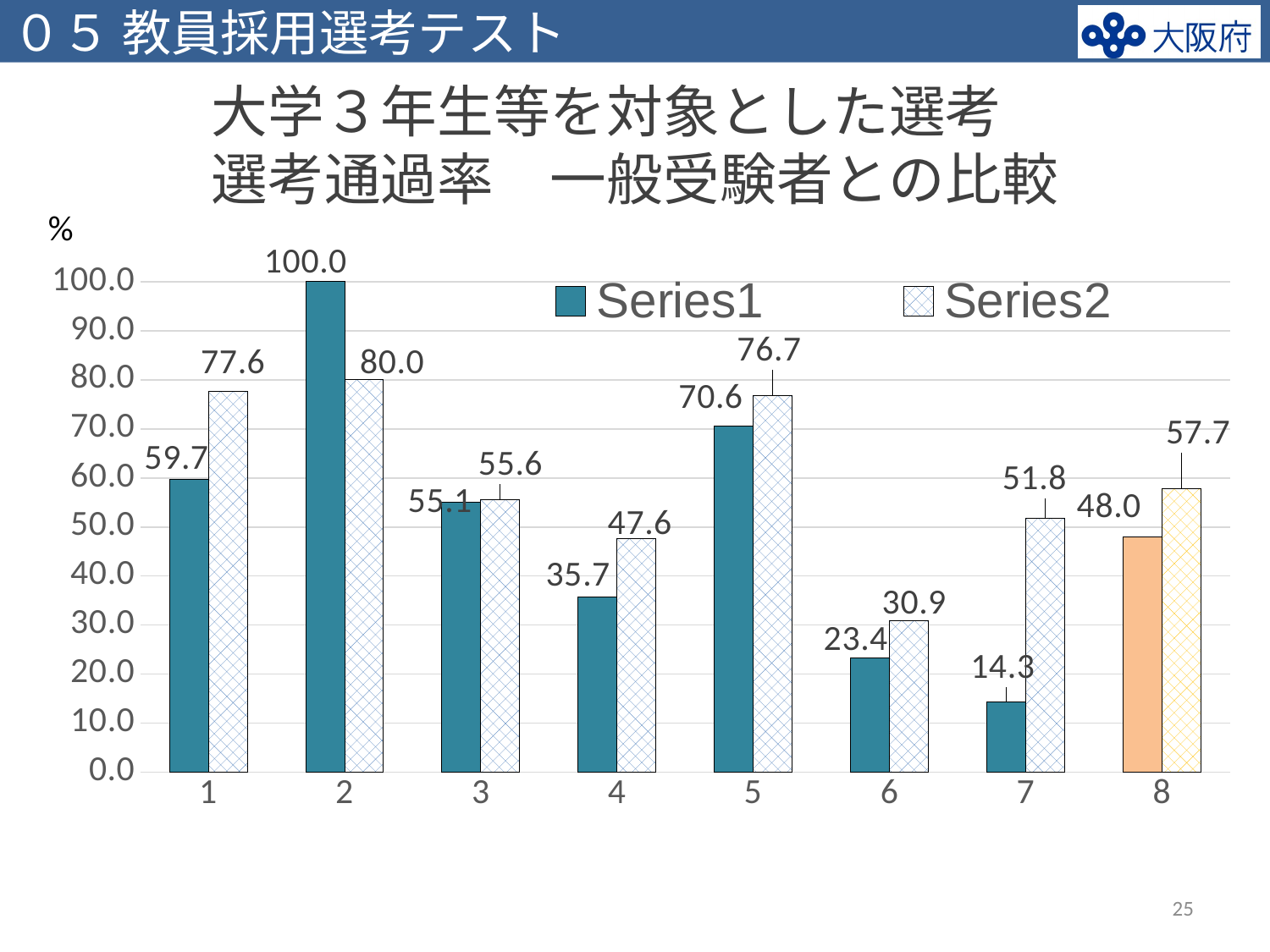
What is the Series2 value for category 7? 51.8 What unit is shown at the top of the y axis? % Which category has the highest Series2 value? 2 What type of chart is shown on the slide? bar chart What is the difference between the Series2 and Series1 values for category 7? 37.5 How many categories are shown on the x axis? 8 How many series does the legend list? 2 Is the Series1 value for category 6 greater or less than 30.0? less What is the Series1 value for category 8? 48.0 Which category has the lowest Series1 value? 7 Which is larger for category 4: the Series1 value or the Series2 value? Series2 What is the Series1 value for category 2? 100.0